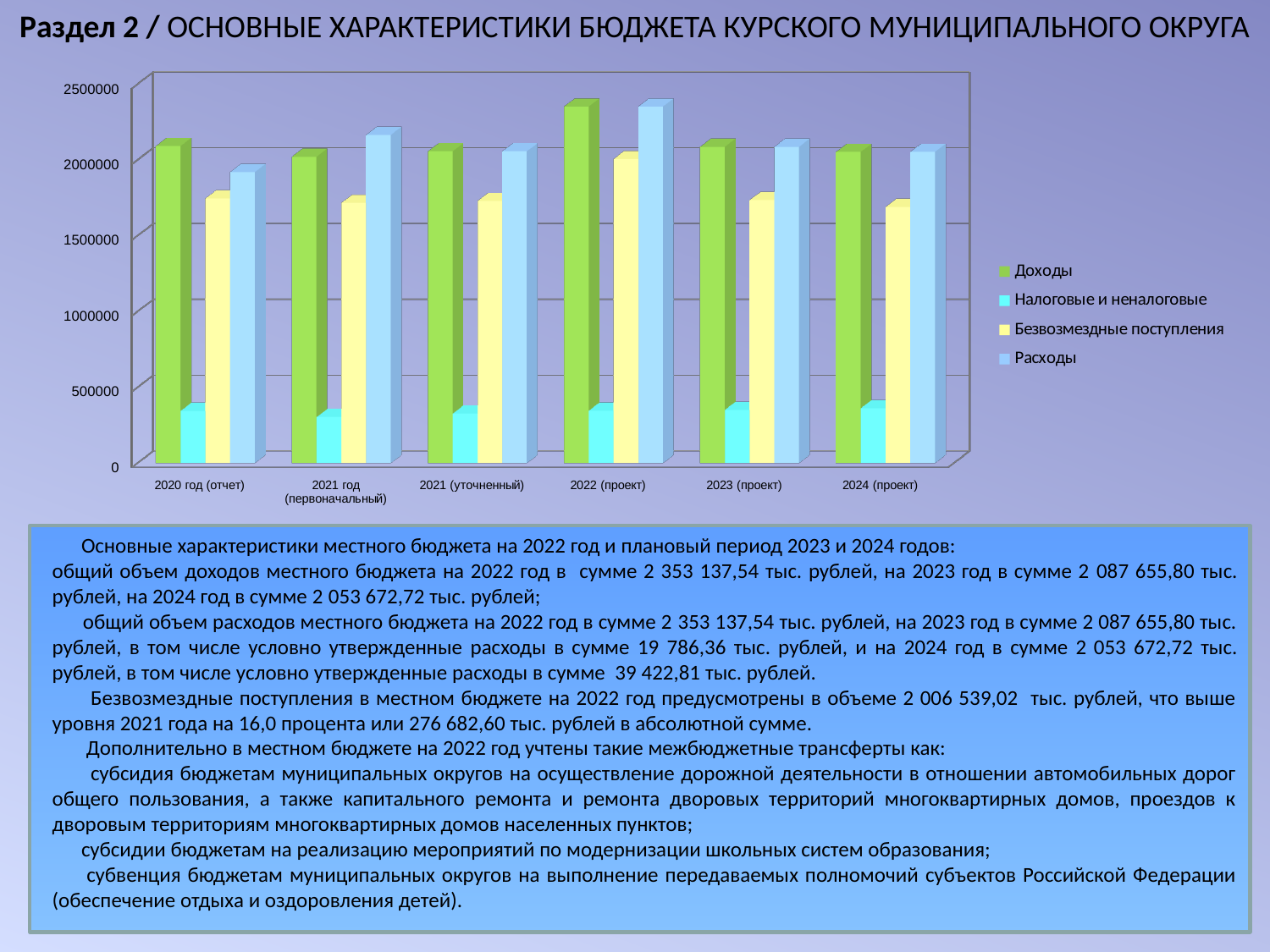
What kind of chart is shown on the slide? bar chart How many categories are shown on the x axis of the chart? 6 In which category is the value for Доходы highest? 2022 (проект) Which is larger in 2020 год (отчет): Доходы or Налоговые и неналоговые? Доходы Do the values for Доходы rise or fall from 2022 (проект) to 2024 (проект)? fall Is the value for Доходы in 2022 (проект) greater or less than 2000000? greater How many series does the chart legend list? 4 Is the value for Безвозмездные поступления in 2020 год (отчет) greater or less than 1500000? greater Which series is shown in green in the chart? Доходы Is the value for Налоговые и неналоговые in 2020 год (отчет) greater or less than 500000? less What is the last entry in the chart legend? Расходы